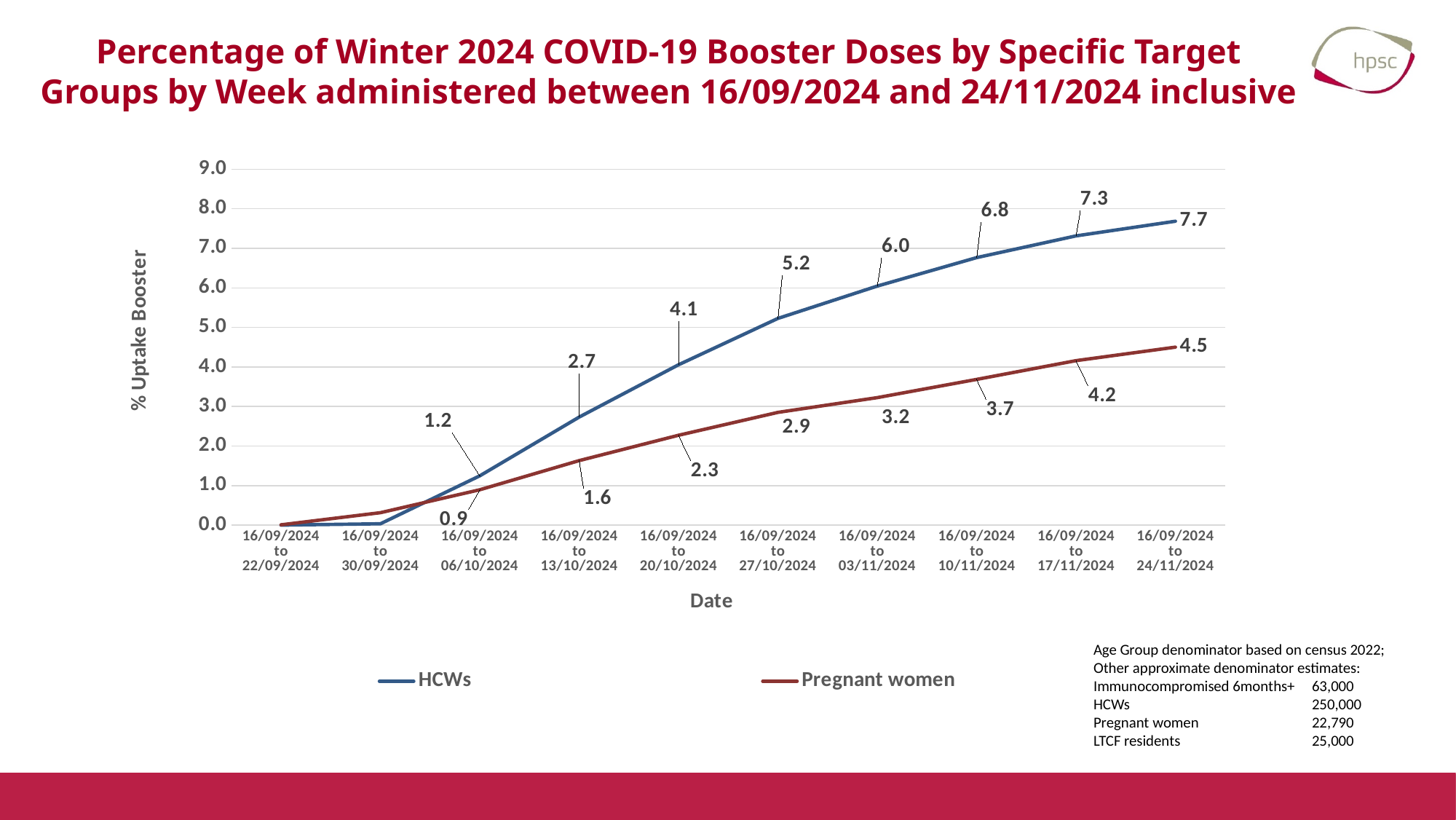
What is the % uptake for Pregnant women in the week 16/09/2024 to 13/10/2024? 1.6 Which series has the higher value in the week 16/09/2024 to 10/11/2024, HCWs or Pregnant women? HCWs What is the % uptake for HCWs in the week 16/09/2024 to 20/10/2024? 4.1 What is the % uptake for Pregnant women in the week 16/09/2024 to 24/11/2024? 4.5 What colour is the line for Pregnant women? Red How many series does the legend list? 2 How many weekly periods are shown on the x axis? 10 Is the value for Pregnant women in the week 16/09/2024 to 30/09/2024 greater or less than 1.0? less What is the % uptake for HCWs in the week 16/09/2024 to 24/11/2024? 7.7 What is the difference between the HCWs and Pregnant women values in the week 16/09/2024 to 24/11/2024? 3.2 Does the HCWs line rise or fall across the weeks from left to right? Rise What type of chart is shown on the slide? Line chart